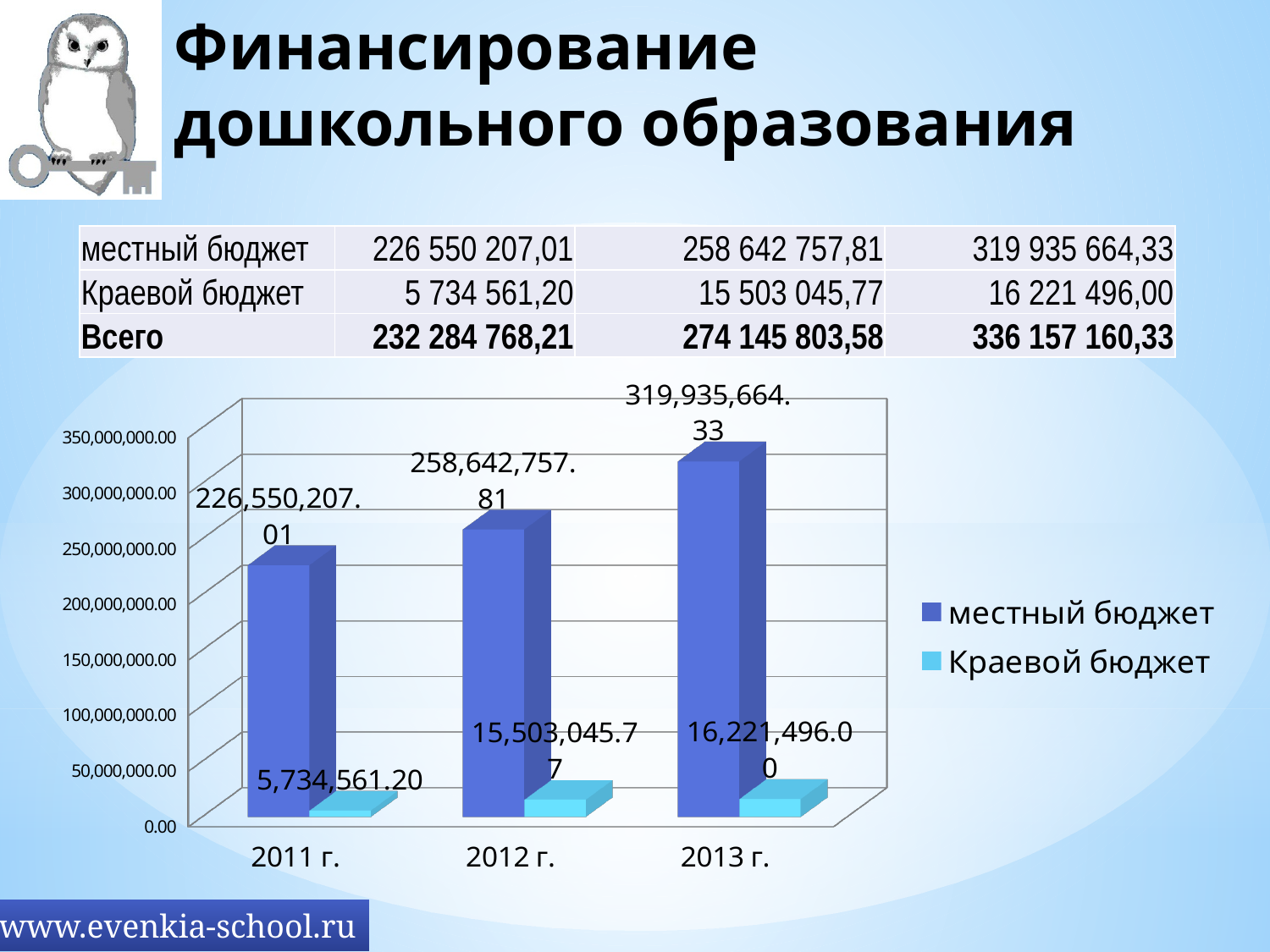
What is the value for Краевой бюджет in 2012 г.? 15,503,045.77 What is the difference between местный бюджет in 2013 г. and in 2011 г.? 93,385,457.32 What is the value for местный бюджет in 2011 г.? 226,550,207.01 Does местный бюджет rise or fall from 2011 г. to 2013 г.? rise Which is larger: Краевой бюджет in 2012 г. or in 2013 г.? 2013 г. What is the value for местный бюджет in 2013 г.? 319,935,664.33 What is the value for Краевой бюджет in 2011 г.? 5,734,561.20 How many years are shown on the x axis of the chart? 3 How many series does the chart legend list? 2 Is the value for местный бюджет in 2012 г. greater or less than 250,000,000.00? greater In which year is местный бюджет highest? 2013 г. In which year is Краевой бюджет lowest? 2011 г.